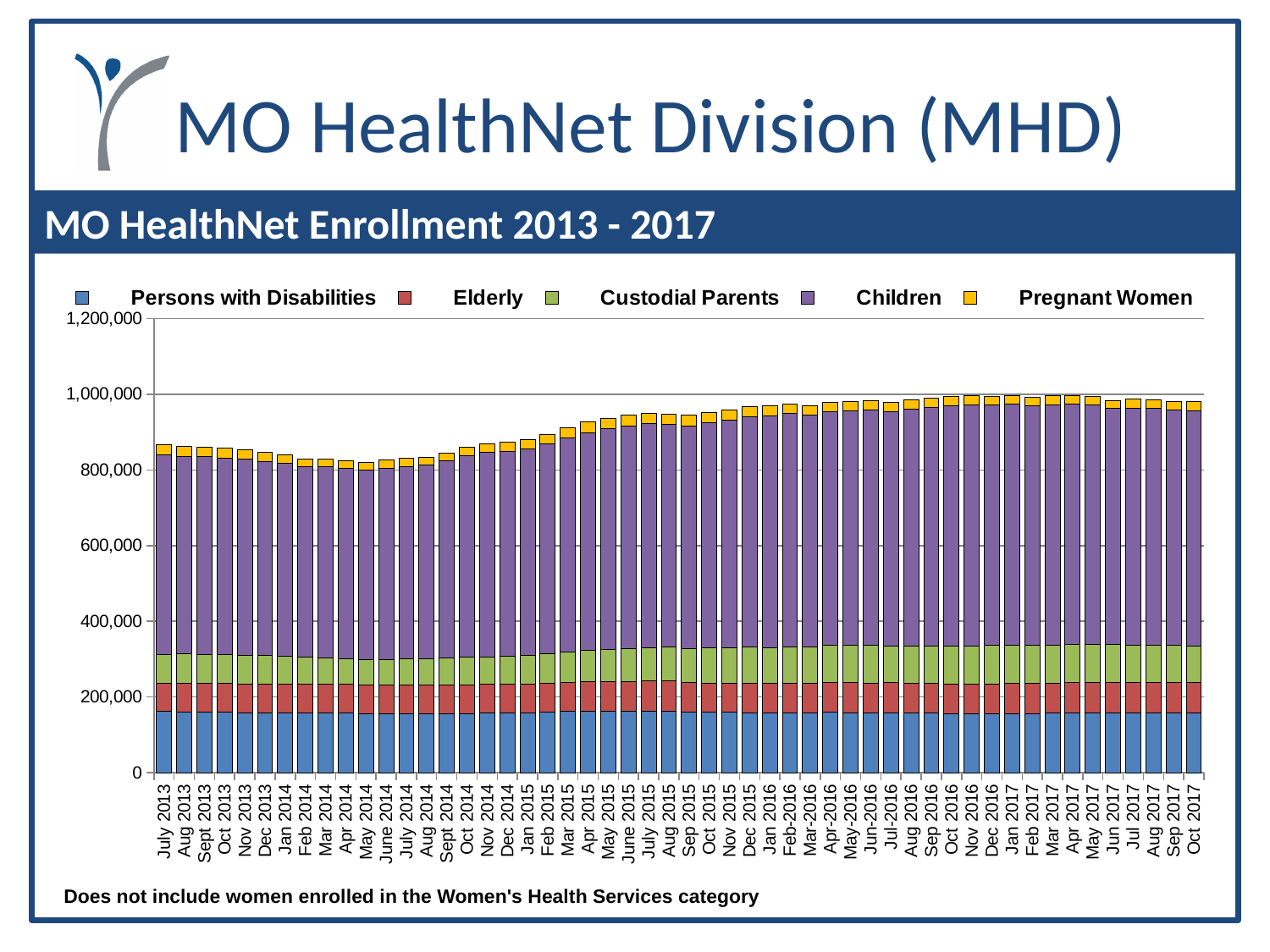
What kind of chart is shown on the slide? Stacked bar chart What is the title of the chart? MO HealthNet Enrollment 2013 - 2017 Is the total enrollment larger in Oct 2017 or in July 2013? Oct 2017 Is the total enrollment for Oct 2017 greater or less than 1,000,000? less Is the Persons with Disabilities value for Oct 2017 greater or less than 200,000? less Which series is listed first in the legend? Persons with Disabilities Which series makes up the largest portion of each stacked bar? Children Does total enrollment generally rise or fall from July 2013 to Oct 2017? rise How many monthly bars are plotted in the chart? 52 Which series makes up the smallest portion of each stacked bar? Pregnant Women Is the total enrollment for July 2013 greater or less than 800,000? greater How many series does the legend list? 5